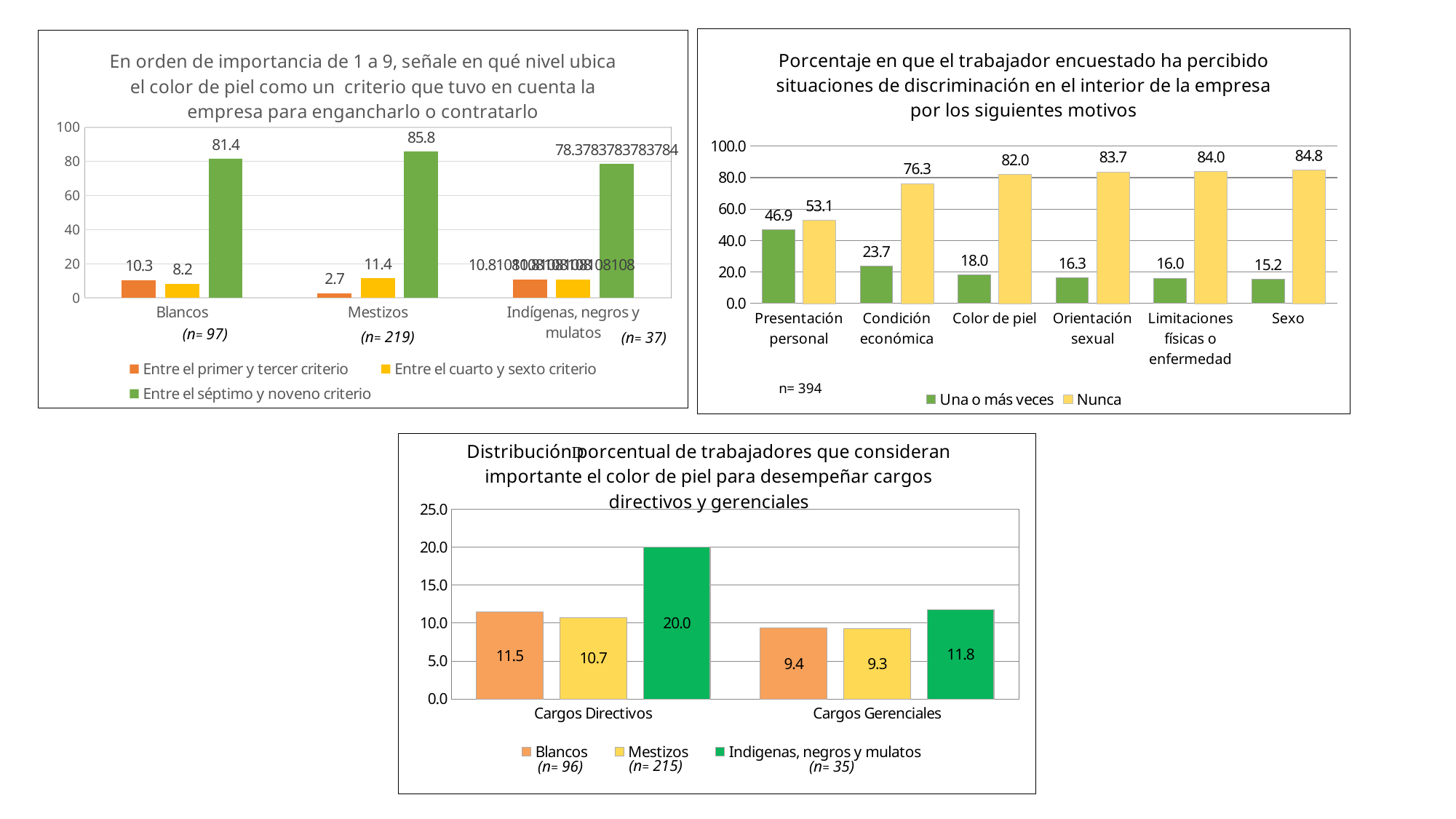
In the top-right chart (Porcentaje en que el trabajador encuestado ha percibido situaciones de discriminación), what is the difference between 'Nunca' and 'Una o más veces' for Condición económica? 52.6 In the top-right chart (Porcentaje en que el trabajador encuestado ha percibido situaciones de discriminación), how many categories are shown on the x axis? 6 In the bottom chart (Distribución porcentual de trabajadores que consideran importante el color de piel...), which group has the lowest value in Cargos Gerenciales? Mestizos In the top-left chart (En orden de importancia de 1 a 9...), what is the value of 'Entre el primer y tercer criterio' for Blancos? 10.3 In the top-right chart (Porcentaje en que el trabajador encuestado ha percibido situaciones de discriminación), which category has the highest value for 'Una o más veces'? Presentación personal In the top-right chart (Porcentaje en que el trabajador encuestado ha percibido situaciones de discriminación), what is the value of 'Una o más veces' for Presentación personal? 46.9 In the bottom chart (Distribución porcentual de trabajadores que consideran importante el color de piel...), what is the value for Indigenas, negros y mulatos in Cargos Directivos? 20.0 In the bottom chart (Distribución porcentual de trabajadores que consideran importante el color de piel...), what is the difference between Blancos and Mestizos in Cargos Directivos? 0.8 What type of chart is the bottom chart (Distribución porcentual de trabajadores que consideran importante el color de piel...)? Bar chart In the top-right chart (Porcentaje en que el trabajador encuestado ha percibido situaciones de discriminación), what is the value of 'Nunca' for Sexo? 84.8 In the top-left chart (En orden de importancia de 1 a 9...), what is the value of 'Entre el séptimo y noveno criterio' for Mestizos? 85.8 In the top-left chart (En orden de importancia de 1 a 9...), how many series does the legend list? 3